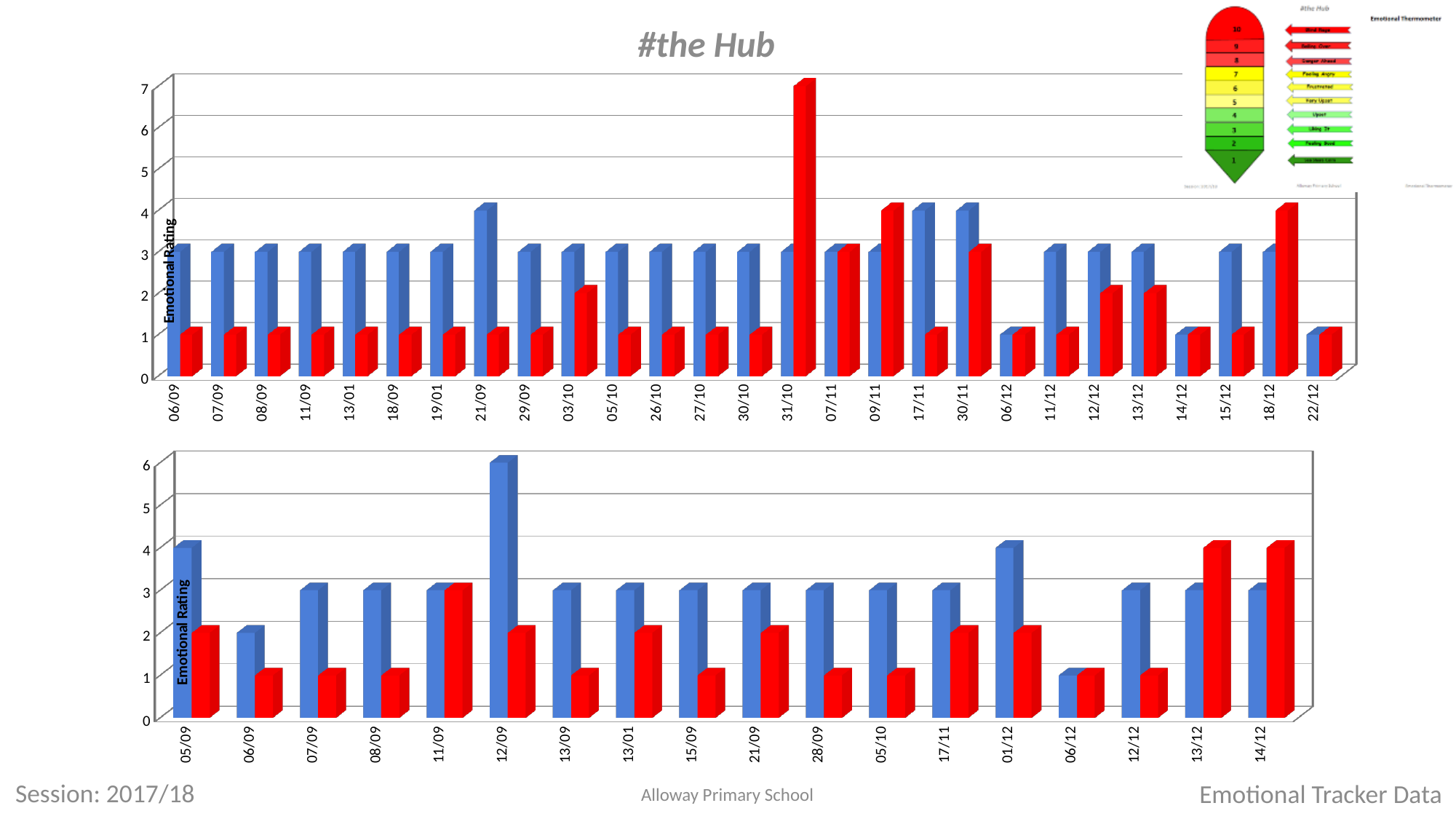
What is the title shown above the charts? #the Hub In the top chart, what value does the red bar for 31/10 reach? 7 In the top chart, on which date does the red bar reach its highest value? 31/10 In the bottom chart, on which date does the blue bar reach its highest value? 12/09 How many dates are shown on the x axis of the top chart? 27 In the bottom chart, which is larger on 13/12, the blue bar or the red bar? the red bar What kind of chart is the top chart on the slide? bar chart What is the label on the vertical axis of the top chart? Emotional Rating In the top chart, is the red bar for 31/10 greater or less than 5? greater In the top chart, which is larger on 31/10, the blue bar or the red bar? the red bar How many dates are shown on the x axis of the bottom chart? 18 In the bottom chart, what value does the blue bar for 12/09 reach? 6